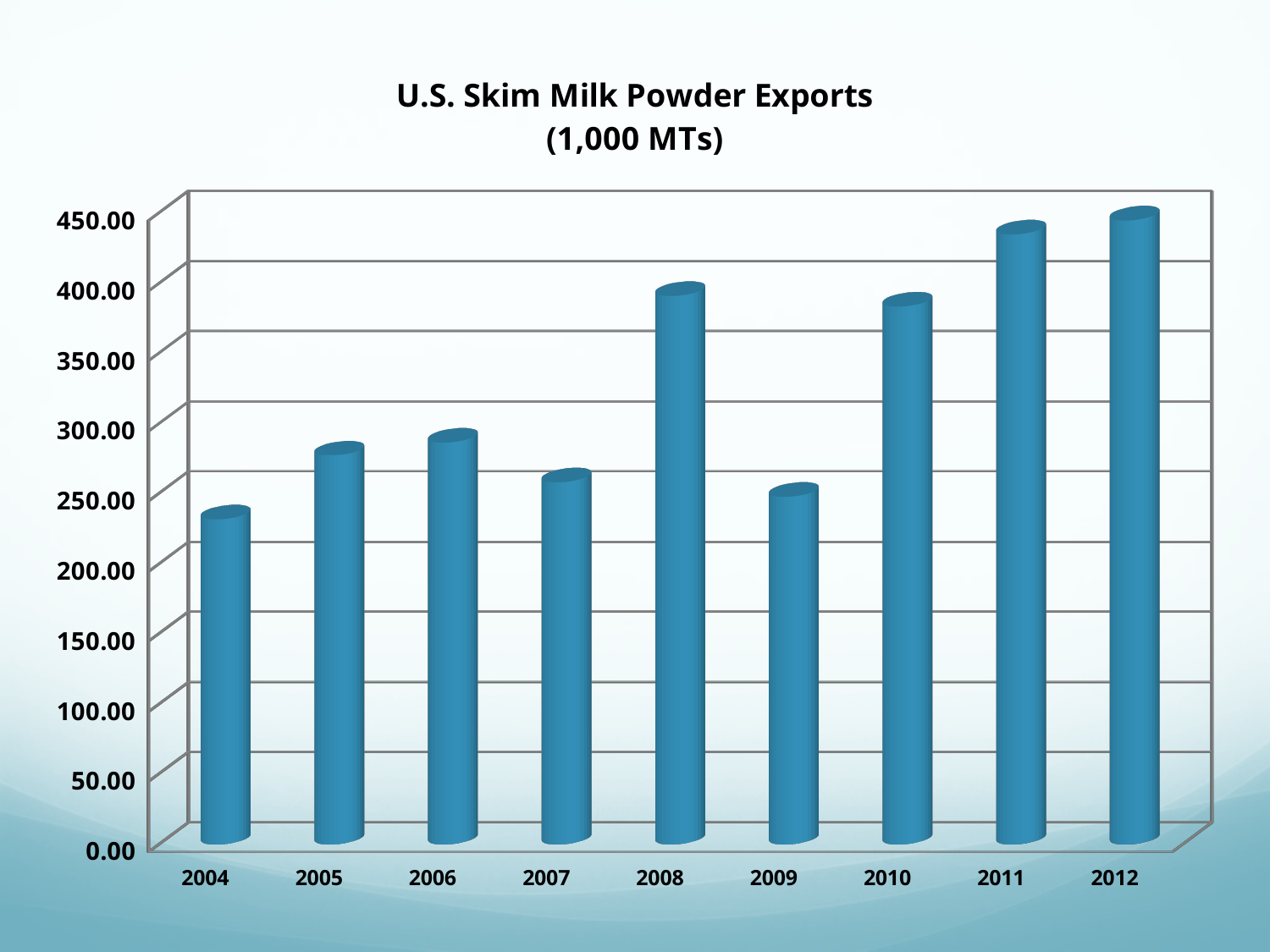
How many years are shown on the x axis of the chart? 9 Is the value for 2004 greater or less than 250? less Is the value for 2008 greater or less than 350? greater Which year has the lowest U.S. skim milk powder exports? 2004 Which year has higher exports, 2005 or 2007? 2005 What is the title of the chart? U.S. Skim Milk Powder Exports (1,000 MTs) Is the value for 2009 greater or less than 200? greater What kind of chart is shown on the slide? bar chart Which year has higher exports, 2006 or 2009? 2006 Do exports rise or fall from 2009 to 2012? rise